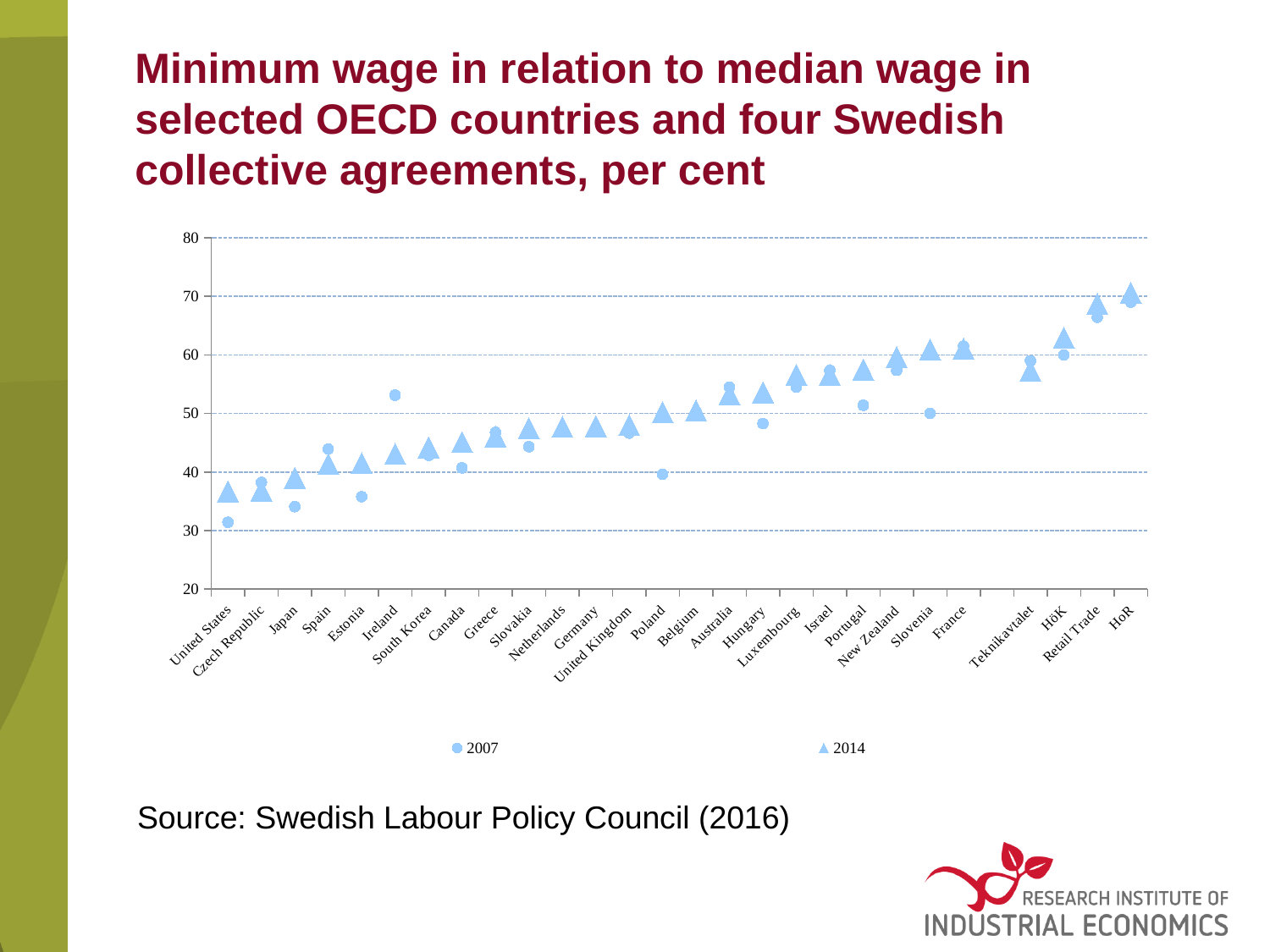
Do the 2014 values generally rise or fall moving from left to right along the x axis? Rise For Poland, which is larger: the 2007 value or the 2014 value? 2014 Is the 2007 value for Ireland greater or less than 50? greater Which category has the highest 2007 value? HoR How many series does the legend list? 2 Is the 2014 value for Teknikavtalet greater or less than 60? less Which category has the lowest 2007 value? United States How many countries and agreements are plotted along the x axis? 27 For Ireland, which is larger: the 2007 value or the 2014 value? 2007 What are the two series shown in the legend? 2007 and 2014 What kind of chart is this? Scatter (dot) chart Is the 2007 value for the United States greater or less than 40? less